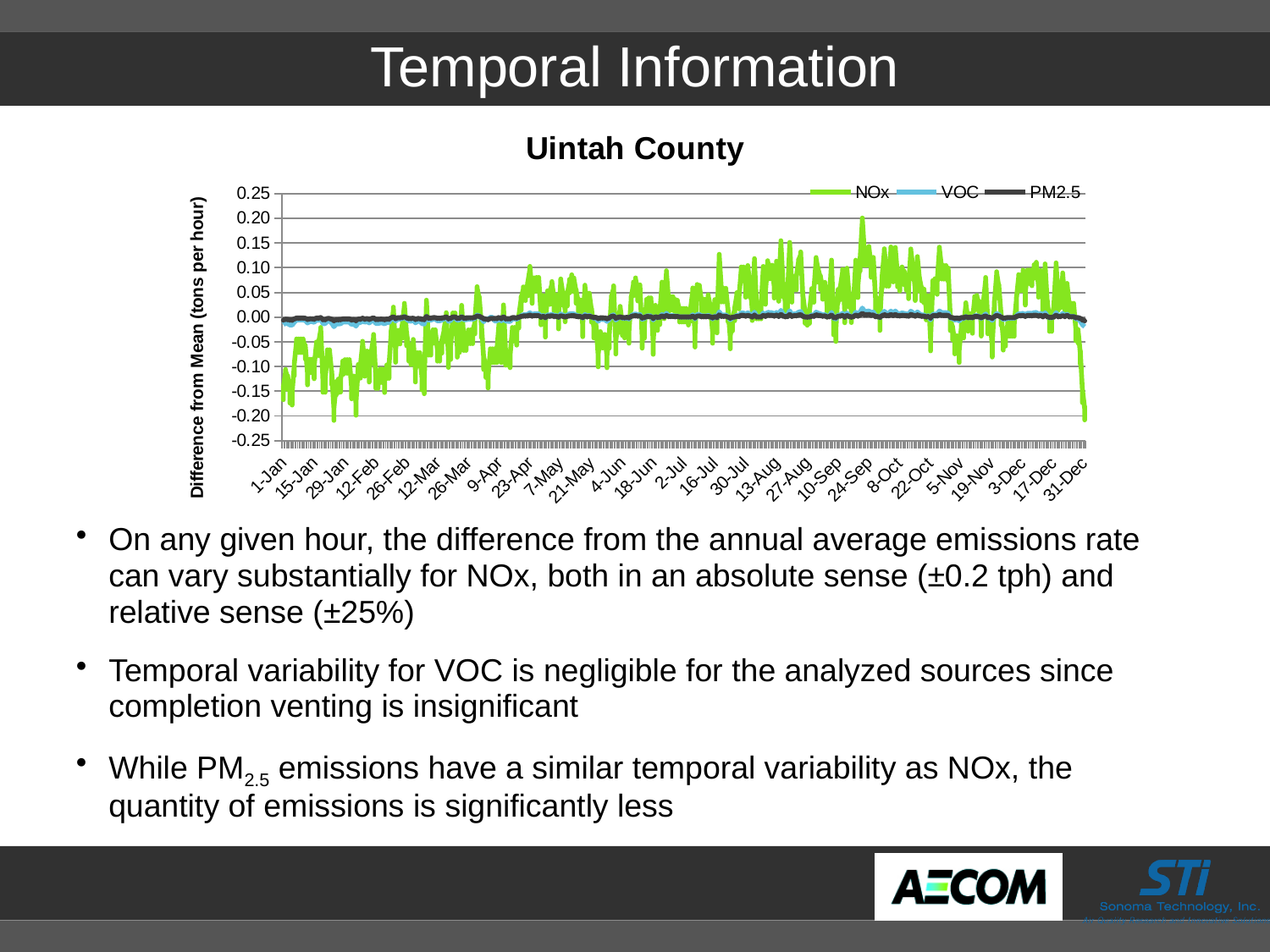
Is the peak NOx value around 24-Sep greater or less than 0.15? greater What is the minimum value shown on the vertical axis of the chart? -0.25 Is the NOx value around 29-Jan greater or less than -0.05? less How many series does the legend of the Uintah County chart list? 3 What is the maximum value shown on the vertical axis of the chart? 0.25 What is the title of the chart? Uintah County Which series is larger in magnitude around 13-Aug, NOx or VOC? NOx Which series in the chart shows the largest variation from zero over the year? NOx What type of chart is shown on the slide? Line chart Does the NOx series generally rise or fall from January to September? rise What is the label of the vertical axis of the chart? Difference from Mean (tons per hour) Is the NOx value in early January (around 1-Jan) greater or less than 0.00? less